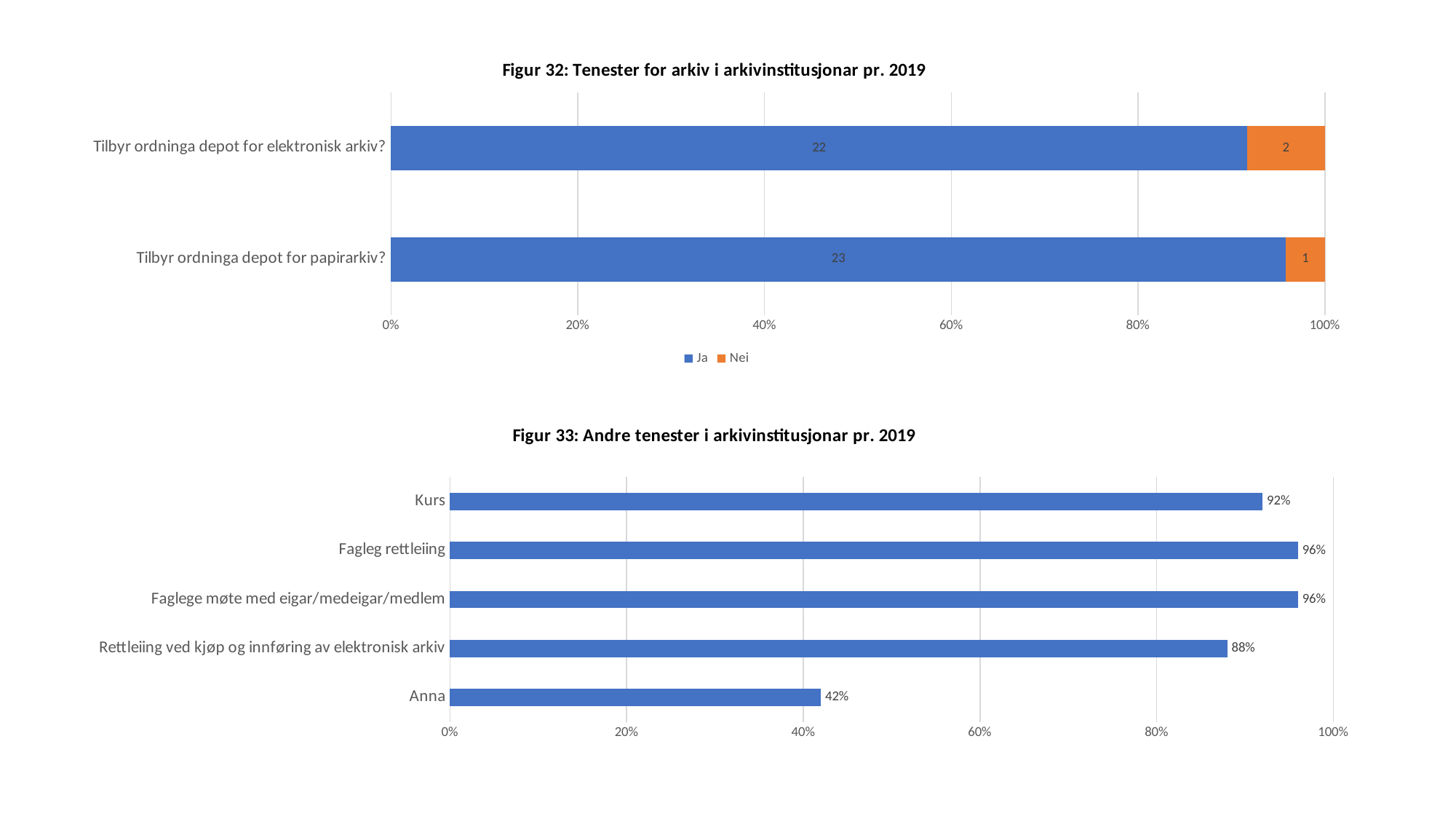
What kind of chart is 'Figur 33: Andre tenester i arkivinstitusjonar pr. 2019'? Bar chart In the chart 'Figur 33: Andre tenester i arkivinstitusjonar pr. 2019', which category has the lowest value? Anna In the chart 'Figur 33: Andre tenester i arkivinstitusjonar pr. 2019', what is the difference between 'Fagleg rettleiing' and 'Anna'? 54% In the chart 'Figur 32: Tenester for arkiv i arkivinstitusjonar pr. 2019', what colour represents 'Nei'? Orange In the chart 'Figur 32: Tenester for arkiv i arkivinstitusjonar pr. 2019', what is the total of the 'Ja' and 'Nei' values for 'Tilbyr ordninga depot for elektronisk arkiv?'? 24 In the chart 'Figur 32: Tenester for arkiv i arkivinstitusjonar pr. 2019', how many series does the legend list? 2 In the chart 'Figur 32: Tenester for arkiv i arkivinstitusjonar pr. 2019', what is the 'Ja' value for 'Tilbyr ordninga depot for elektronisk arkiv?'? 22 In the chart 'Figur 33: Andre tenester i arkivinstitusjonar pr. 2019', how many categories are shown? 5 In the chart 'Figur 32: Tenester for arkiv i arkivinstitusjonar pr. 2019', which category has the higher 'Nei' value? Tilbyr ordninga depot for elektronisk arkiv? In the chart 'Figur 33: Andre tenester i arkivinstitusjonar pr. 2019', is the value for 'Rettleiing ved kjøp og innføring av elektronisk arkiv' greater or less than 80%? greater In the chart 'Figur 33: Andre tenester i arkivinstitusjonar pr. 2019', what is the value for 'Kurs'? 92% In the chart 'Figur 32: Tenester for arkiv i arkivinstitusjonar pr. 2019', what is the 'Nei' value for 'Tilbyr ordninga depot for papirarkiv?'? 1